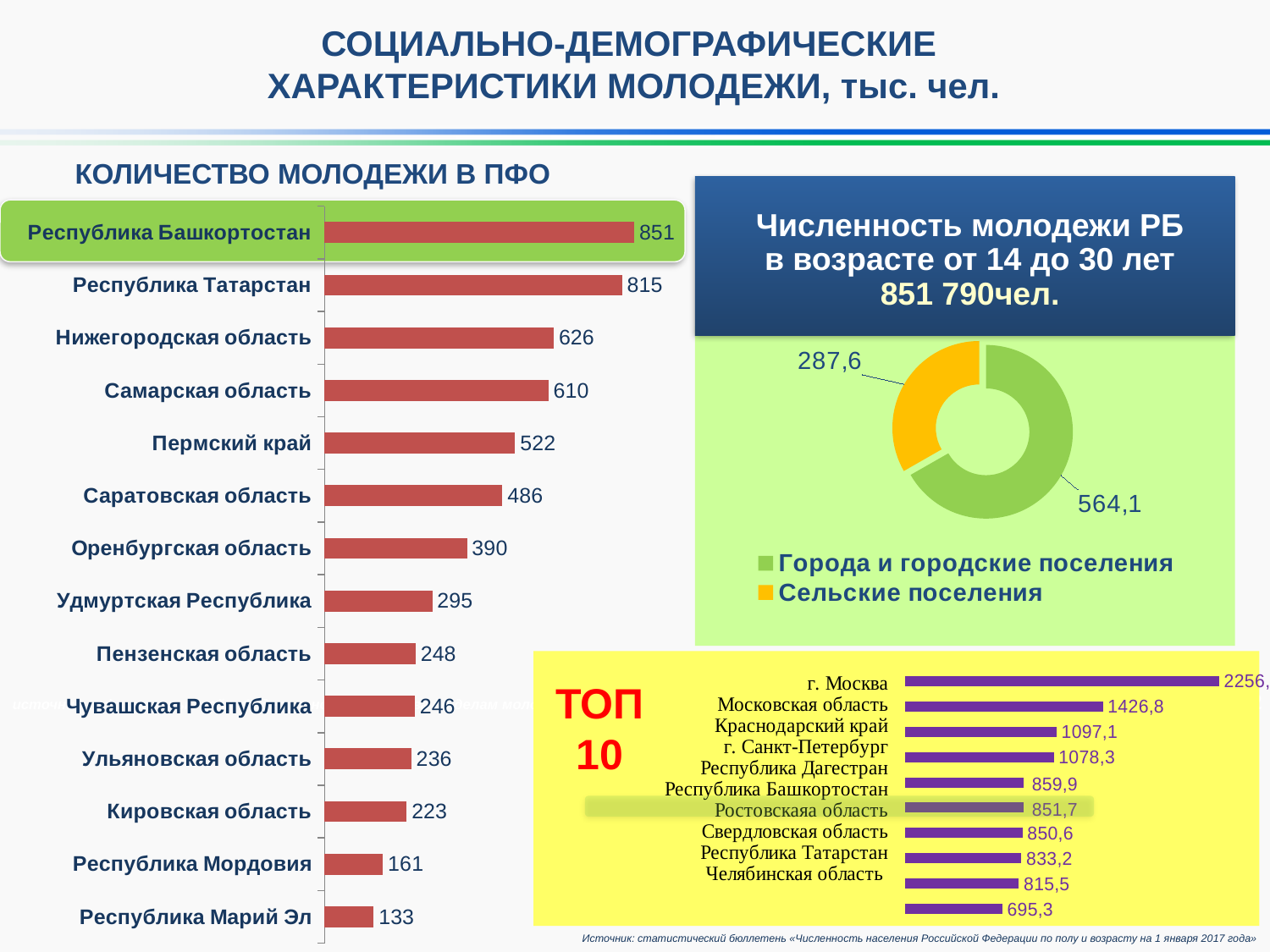
In the chart 'КОЛИЧЕСТВО МОЛОДЕЖИ В ПФО', what is the difference between Республика Башкортостан and Республика Татарстан? 36 In the 'ТОП 10' chart at the bottom right, what is the lowest value shown? 695,3 In the chart 'КОЛИЧЕСТВО МОЛОДЕЖИ В ПФО', which is larger: Самарская область or Саратовская область? Самарская область In the donut chart on the right, what is the value for Сельские поселения? 287,6 In the donut chart on the right, what is the value for Города и городские поселения? 564,1 In the chart 'КОЛИЧЕСТВО МОЛОДЕЖИ В ПФО', which region has the lowest value? Республика Марий Эл In the chart 'КОЛИЧЕСТВО МОЛОДЕЖИ В ПФО', what is the value for Республика Татарстан? 815 How many entries does the legend of the donut chart on the right list? 2 In the chart 'КОЛИЧЕСТВО МОЛОДЕЖИ В ПФО', which region has the highest value? Республика Башкортостан What kind of chart is 'КОЛИЧЕСТВО МОЛОДЕЖИ В ПФО'? Bar chart How many regions are shown in the chart 'КОЛИЧЕСТВО МОЛОДЕЖИ В ПФО'? 14 In the chart 'КОЛИЧЕСТВО МОЛОДЕЖИ В ПФО', what is the value for Пермский край? 522